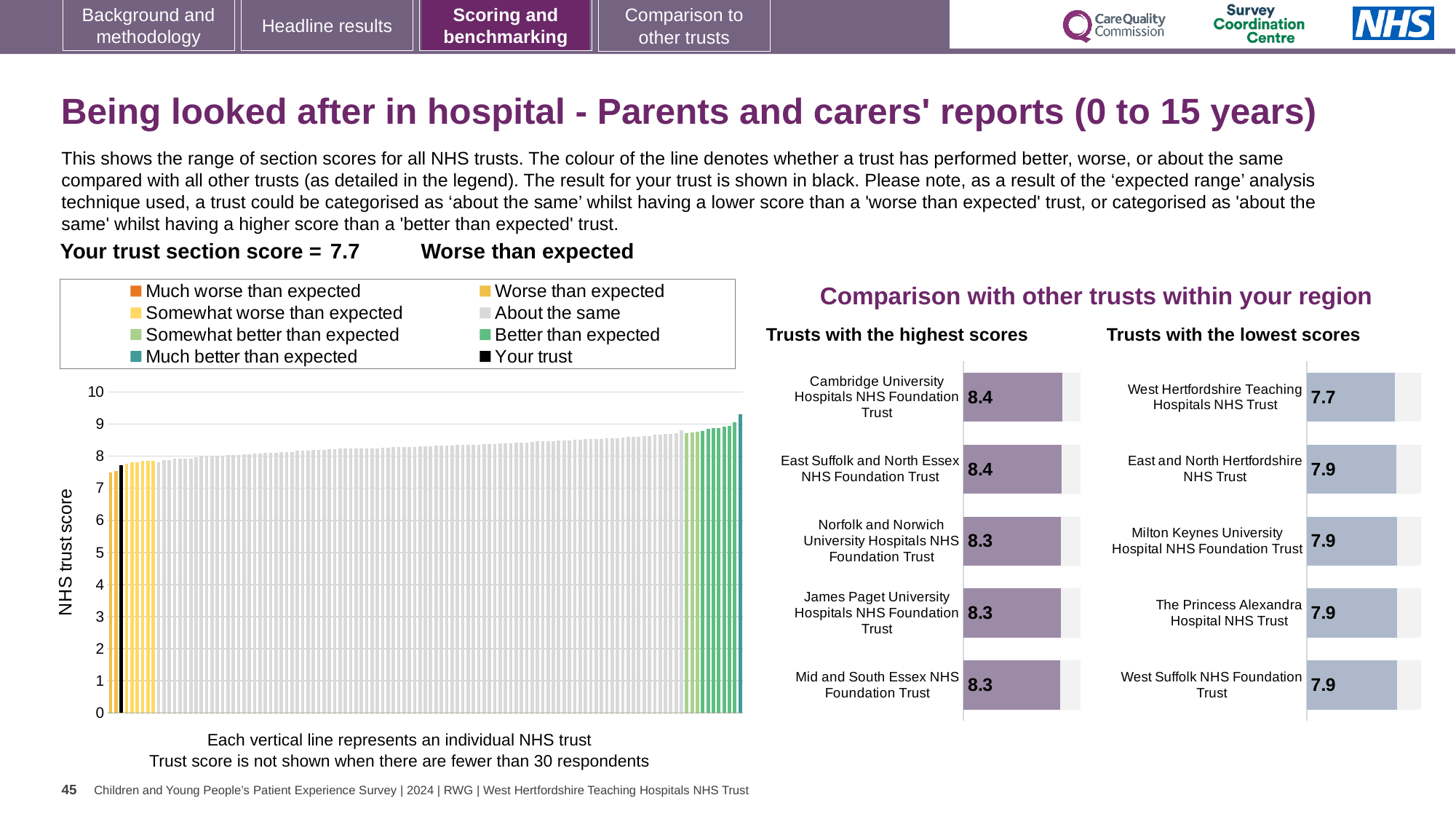
In the 'Trusts with the lowest scores' chart, which trust has the lowest score? West Hertfordshire Teaching Hospitals NHS Trust What type of chart is the large chart on the left showing NHS trust scores? Bar chart In the 'Trusts with the highest scores' chart, what is the difference between the scores for East Suffolk and North Essex NHS Foundation Trust and Norfolk and Norwich University Hospitals NHS Foundation Trust? 0.1 In the 'Trusts with the highest scores' chart, what is the score for Mid and South Essex NHS Foundation Trust? 8.3 In the 'Trusts with the highest scores' chart, what is the score for Cambridge University Hospitals NHS Foundation Trust? 8.4 What is the difference between the score for Cambridge University Hospitals NHS Foundation Trust in the highest scores chart and the score for West Hertfordshire Teaching Hospitals NHS Trust in the lowest scores chart? 0.7 In the 'Trusts with the highest scores' chart, which has the larger score: Cambridge University Hospitals NHS Foundation Trust or James Paget University Hospitals NHS Foundation Trust? Cambridge University Hospitals NHS Foundation Trust In the 'Trusts with the highest scores' chart, how many trusts are listed? 5 How many entries does the legend above the left chart list? 8 In the 'Trusts with the lowest scores' chart, what is the score for West Hertfordshire Teaching Hospitals NHS Trust? 7.7 In the large chart on the left, is the value for the black 'Your trust' bar greater or less than 8? less In the 'Trusts with the lowest scores' chart, how many trusts are listed? 5